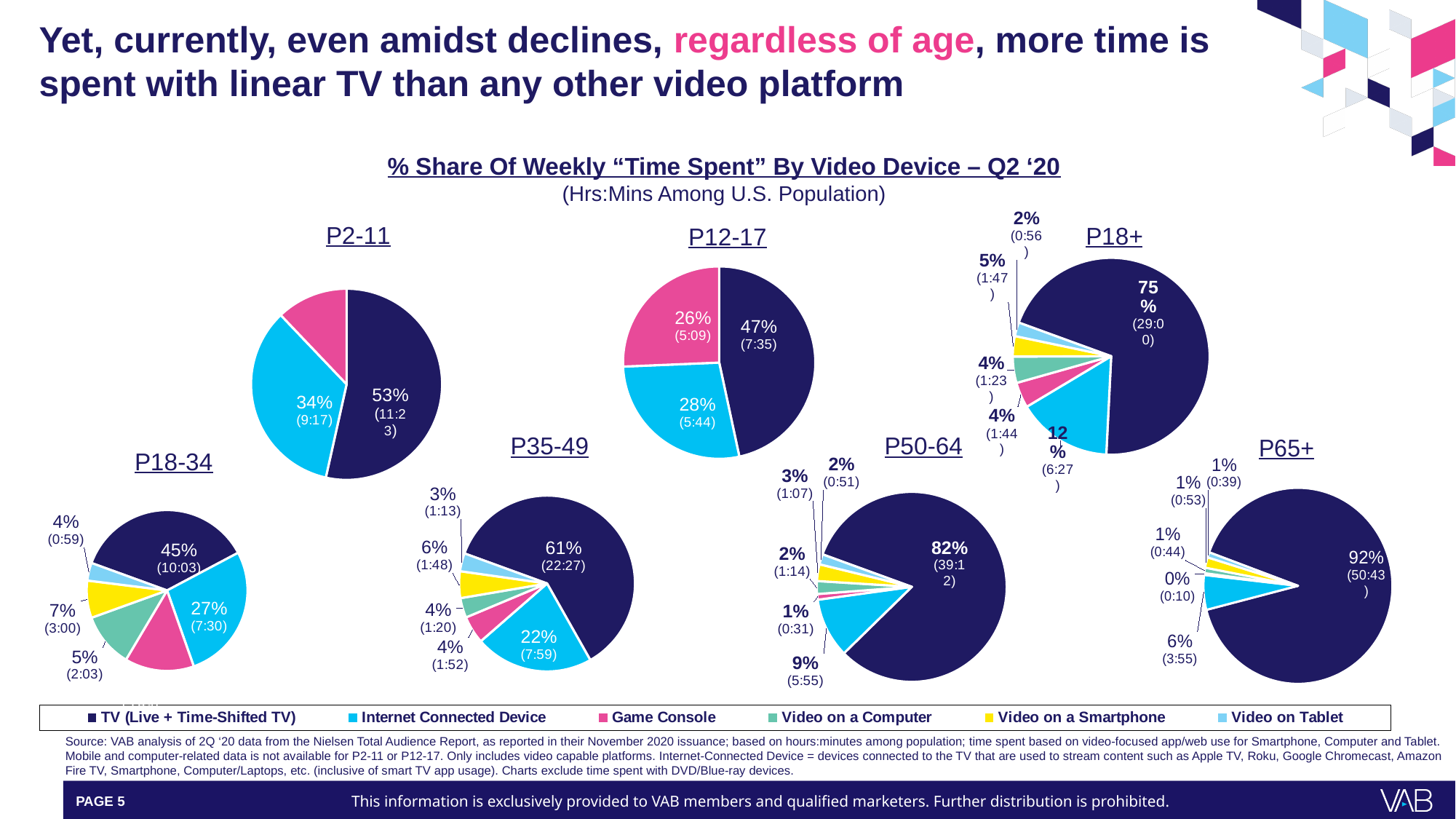
In the P12-17 pie chart, which is larger: the Internet Connected Device share or the Game Console share? Internet Connected Device How many pie charts are shown on the slide? 7 In the P2-11 pie chart, how many hours and minutes are spent with Internet Connected Device? 9:17 In the P18-34 pie chart, what share of time spent goes to TV (Live + Time-Shifted TV)? 45% In the P12-17 pie chart, what share of time spent goes to Game Console? 26% In the P65+ pie chart, what share of weekly time spent goes to TV (Live + Time-Shifted TV)? 92% Across the seven pie charts, which age group has the highest share of time spent with TV (Live + Time-Shifted TV)? P65+ In the P50-64 pie chart, how many hours and minutes are spent with TV (Live + Time-Shifted TV)? 39:12 What kind of chart is used to show the share of weekly time spent for each age group? Pie chart How many video device categories does the legend list? 6 In the P18+ pie chart, what share of time spent goes to Internet Connected Device? 12% In the P35-49 pie chart, what is the difference in percentage points between the TV (Live + Time-Shifted TV) share and the Internet Connected Device share? 39 percentage points